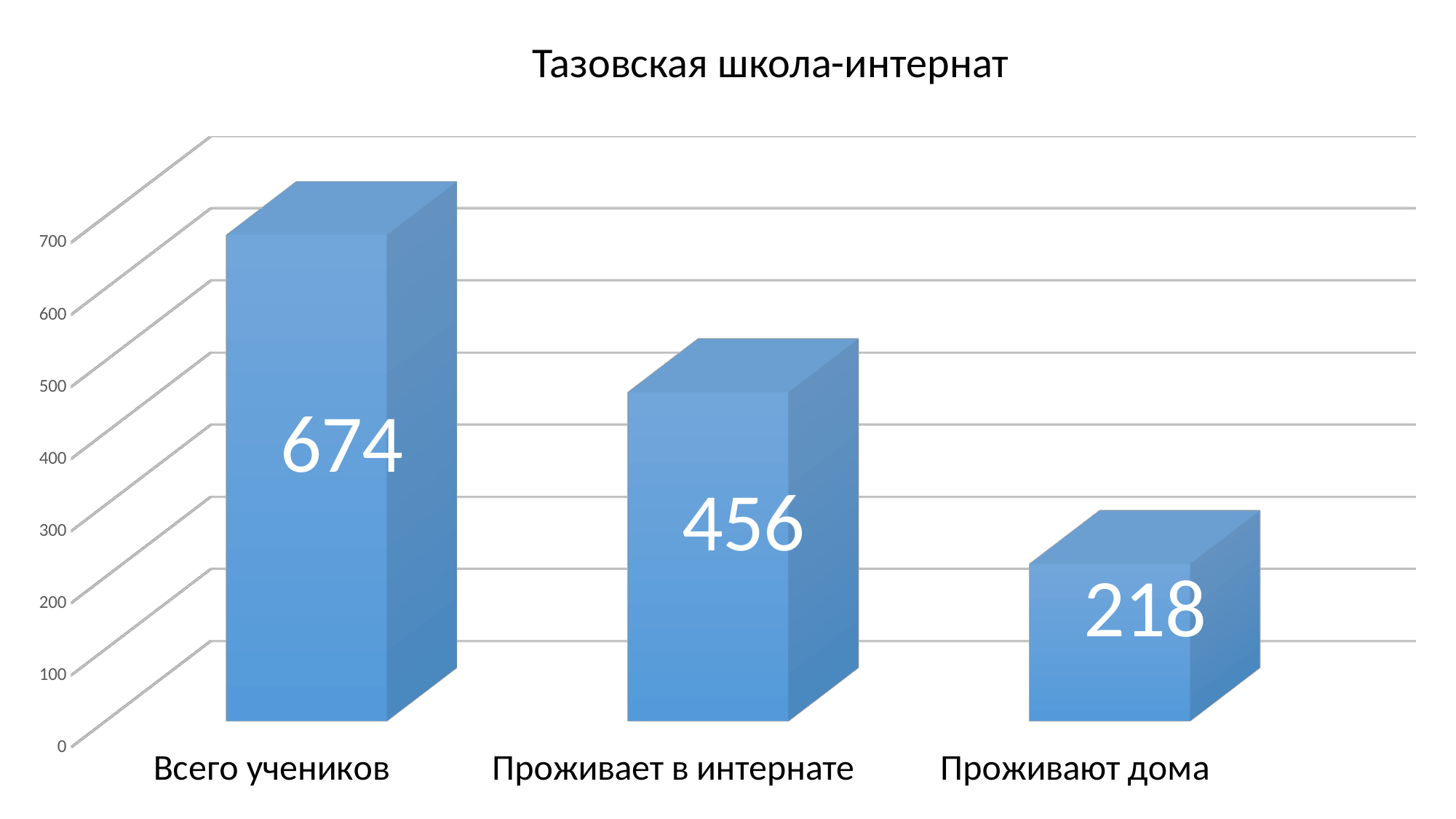
What is the title of the chart? Тазовская школа-интернат What is the difference between the values for Проживает в интернате and Проживают дома? 238 What is the difference between the values for Всего учеников and Проживает в интернате? 218 Is the value for Проживают дома greater or less than 300? less Which is larger, the value for Проживает в интернате or the value for Проживают дома? Проживает в интернате What is the value for Проживает в интернате? 456 What kind of chart is shown on the slide? bar chart What is the value for Всего учеников? 674 Which category has the highest value? Всего учеников Which category has the lowest value? Проживают дома What is the value for Проживают дома? 218 How many categories are shown in the chart? 3